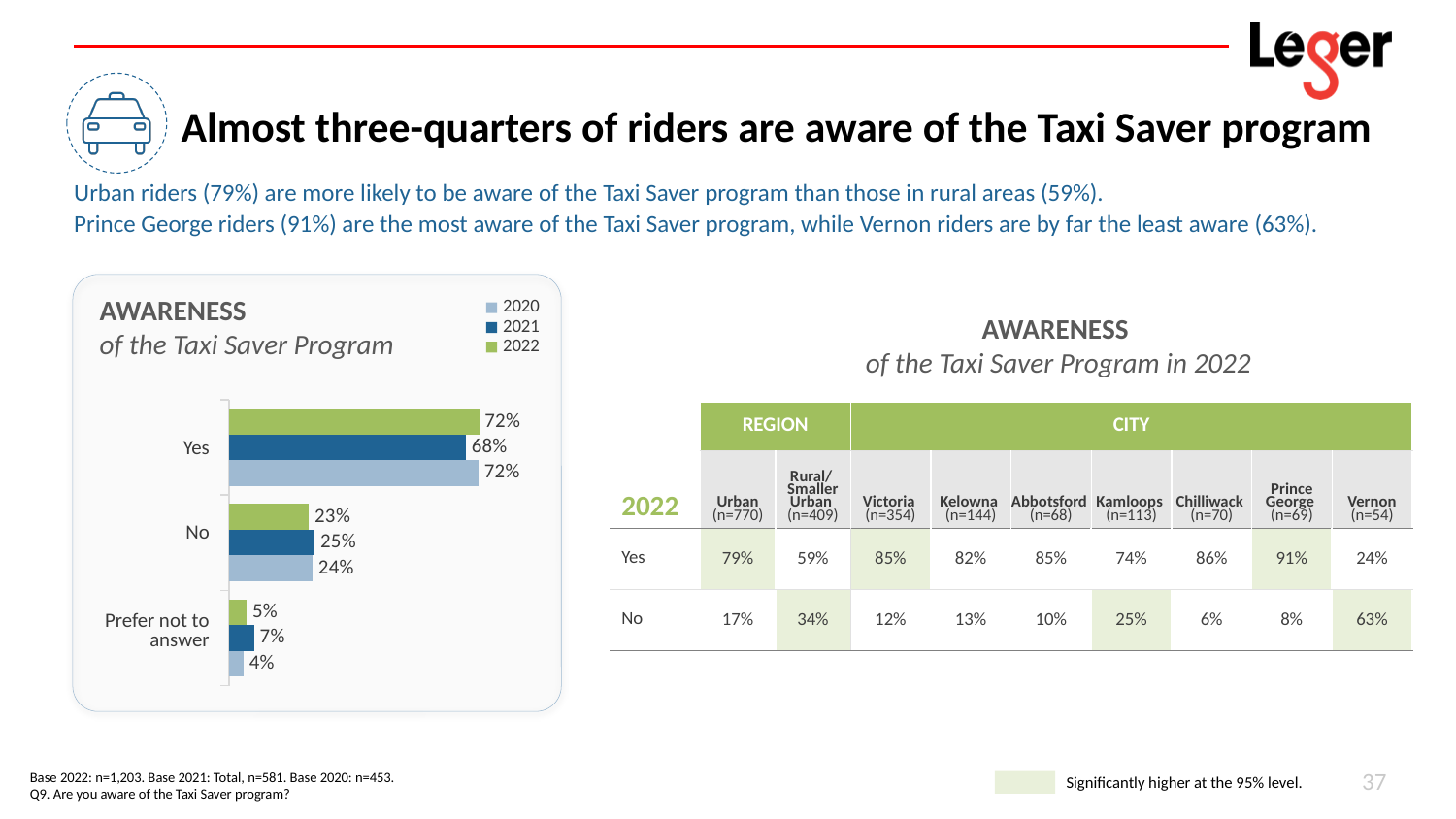
In the AWARENESS of the Taxi Saver Program chart, what is the difference between the Yes value in 2021 and the Yes value in 2020? 4 percentage points In the AWARENESS of the Taxi Saver Program chart, which year has the larger value for No: 2021 or 2022? 2021 In the AWARENESS of the Taxi Saver Program chart, what is the value for Yes in 2022? 72% How many series does the legend of the AWARENESS of the Taxi Saver Program chart list? 3 In the AWARENESS of the Taxi Saver Program chart, what is the value for Prefer not to answer in 2021? 7% How many response categories are shown in the AWARENESS of the Taxi Saver Program chart? 3 In the AWARENESS of the Taxi Saver Program chart, what is the value for Yes in 2021? 68% What are the legend entries in the AWARENESS of the Taxi Saver Program chart? 2020, 2021, 2022 In the AWARENESS of the Taxi Saver Program chart, which category has the lowest value in 2020? Prefer not to answer What kind of chart is the AWARENESS of the Taxi Saver Program chart? Bar chart In the AWARENESS of the Taxi Saver Program chart, which category has the highest value in 2022? Yes In the AWARENESS of the Taxi Saver Program chart, what is the value for No in 2020? 24%